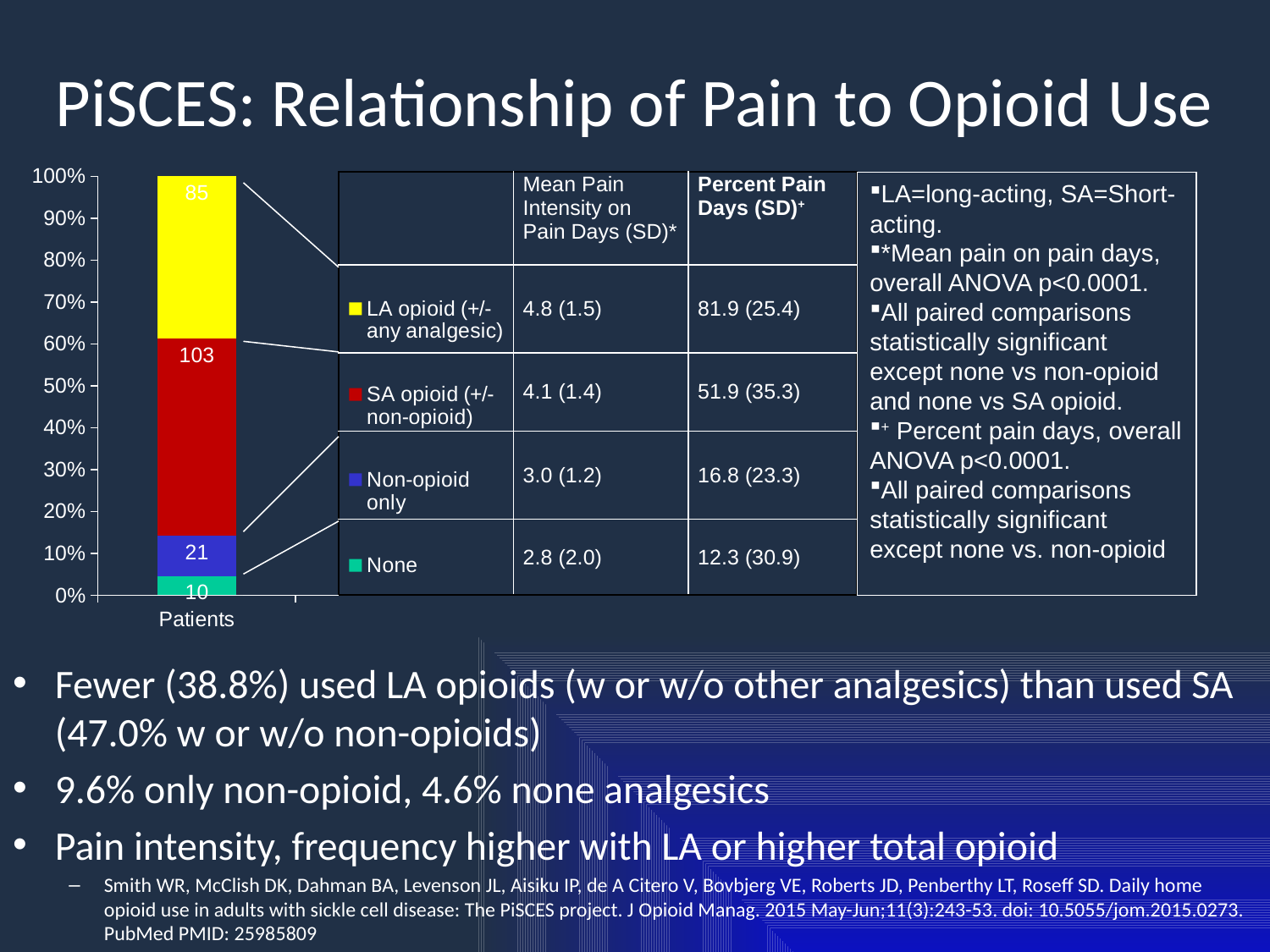
How many series does the chart's legend list? 4 What kind of chart is shown on the slide? stacked bar chart What is the data label for the Non-opioid only segment of the Patients bar? 21 Which is larger, the Non-opioid only segment or the None segment? Non-opioid only What colour is the SA opioid (+/- non-opioid) segment in the chart? red What is the total of all segments in the Patients bar? 219 Which segment of the Patients bar has the largest value? SA opioid (+/- non-opioid) Which segment of the Patients bar has the smallest value? None What is the difference between the SA opioid segment value and the LA opioid segment value? 18 What is the data label for the None segment of the Patients bar? 10 What is the data label for the SA opioid (+/- non-opioid) segment of the Patients bar? 103 What is the data label for the LA opioid (+/- any analgesic) segment of the Patients bar? 85